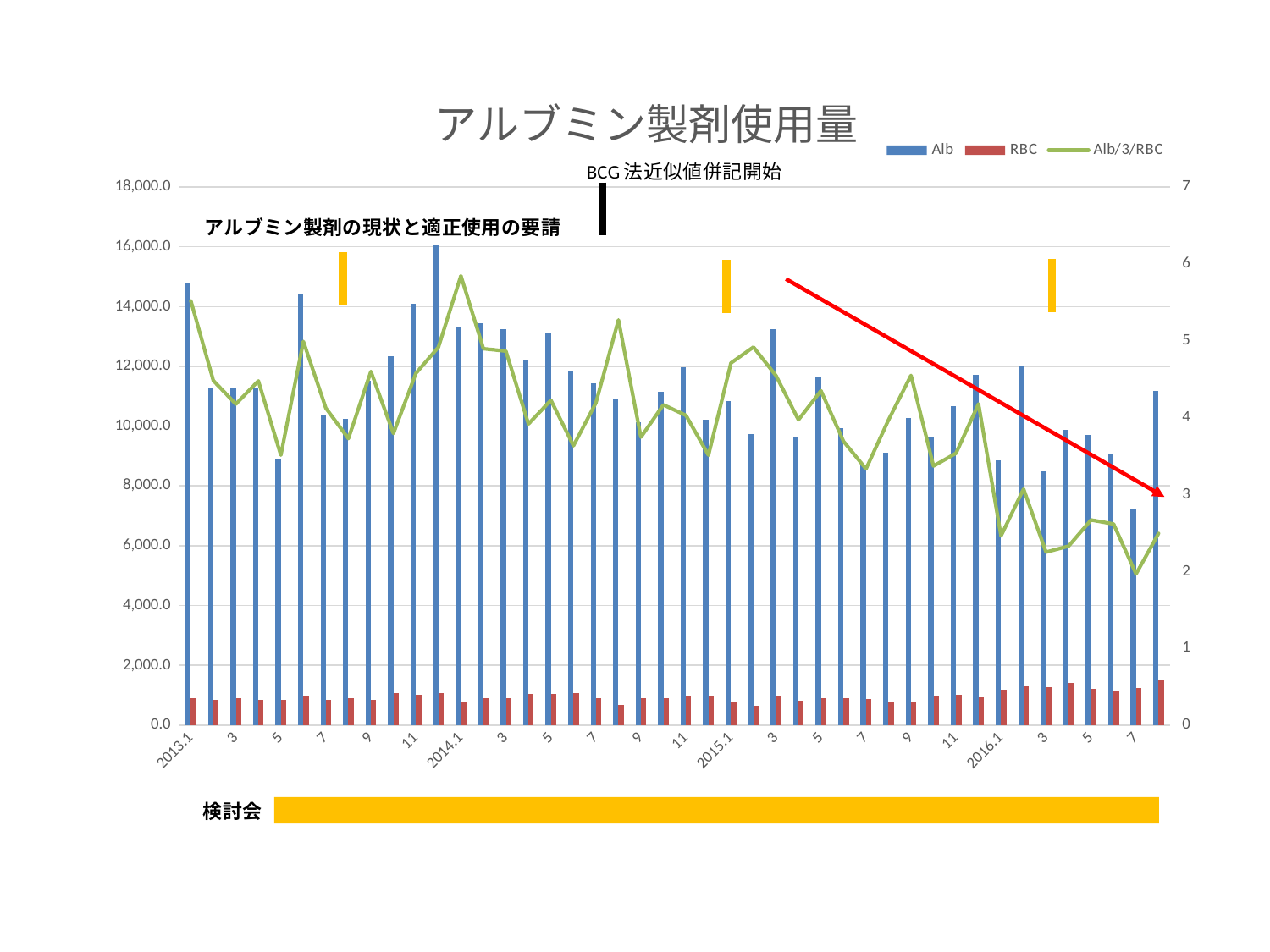
Does the Alb/3/RBC line generally rise or fall from 2013.1 to the end of the x axis? Fall In which month does the Alb series reach its highest value? 2013.12 How many series does the legend list? 3 Is the RBC value for 2013.1 greater or less than 2,000.0? less What is the title of the chart? アルブミン製剤使用量 Is the Alb value for 2016.7 greater or less than 8,000.0? less In which month does the Alb series reach its lowest value? 2016.7 What kind of chart is shown on the slide? A combined bar and line chart Which is larger, the Alb value for 2013.11 or the Alb value for 2016.7? 2013.11 What are the series names listed in the legend? Alb, RBC, Alb/3/RBC